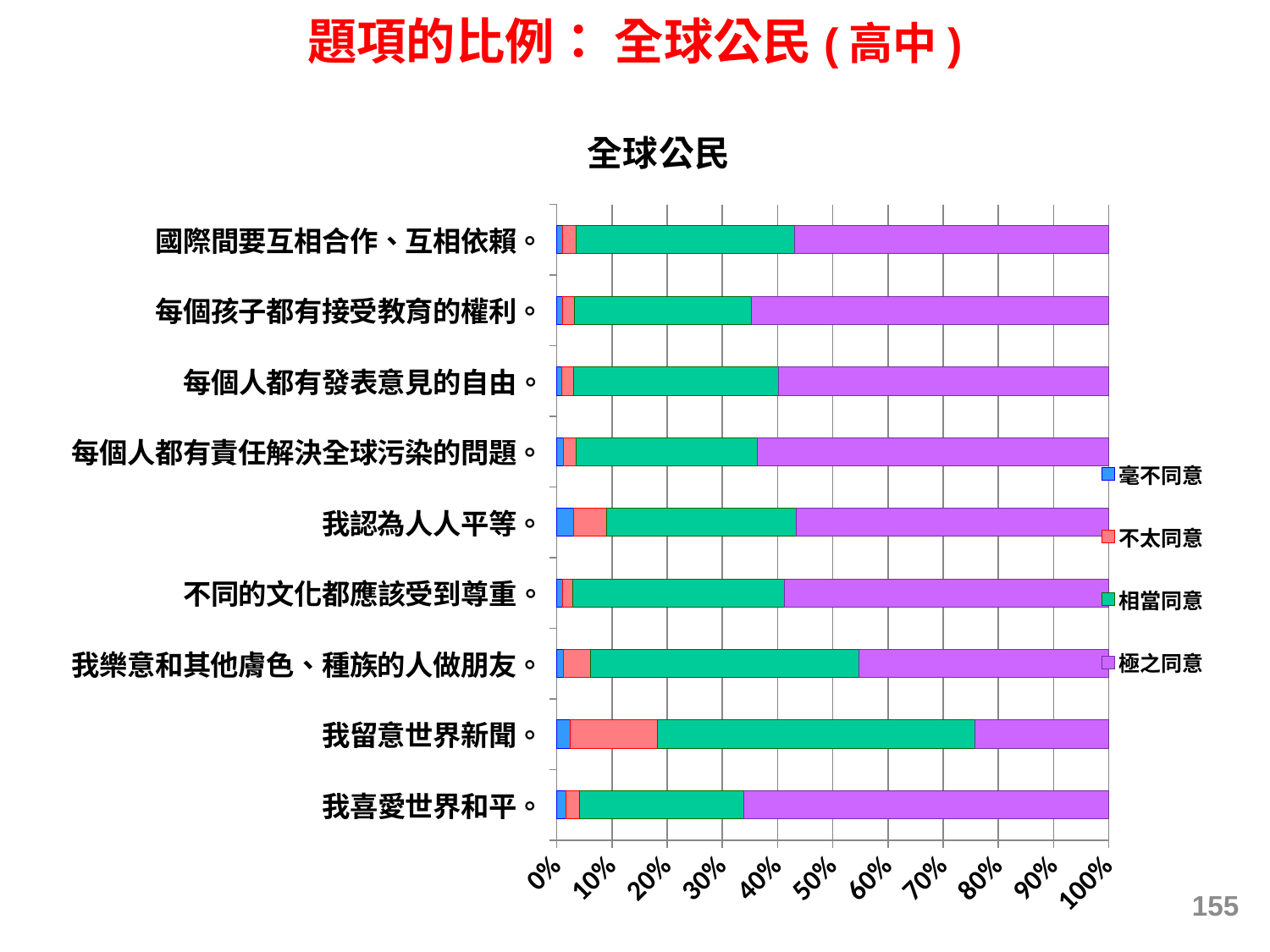
Which statement has the largest 相當同意 share? 我留意世界新聞。 What kind of chart is shown on the slide? stacked bar chart Which legend entry is shown in purple? 極之同意 Which statement has the smallest 極之同意 share? 我留意世界新聞。 Is the 極之同意 share for 我留意世界新聞 greater or less than 30%? less How many statements (categories) are plotted in the chart? 9 What is the title of the chart? 全球公民 Which statement has the largest 不太同意 share? 我留意世界新聞。 Which statement has the larger 極之同意 share: 我認為人人平等 or 我樂意和其他膚色、種族的人做朋友? 我認為人人平等。 What is the total of each stacked bar, as shown by where the bars end on the axis? 100% Is the 極之同意 share for 我喜愛世界和平 greater or less than 60%? greater How many series does the legend list? 4